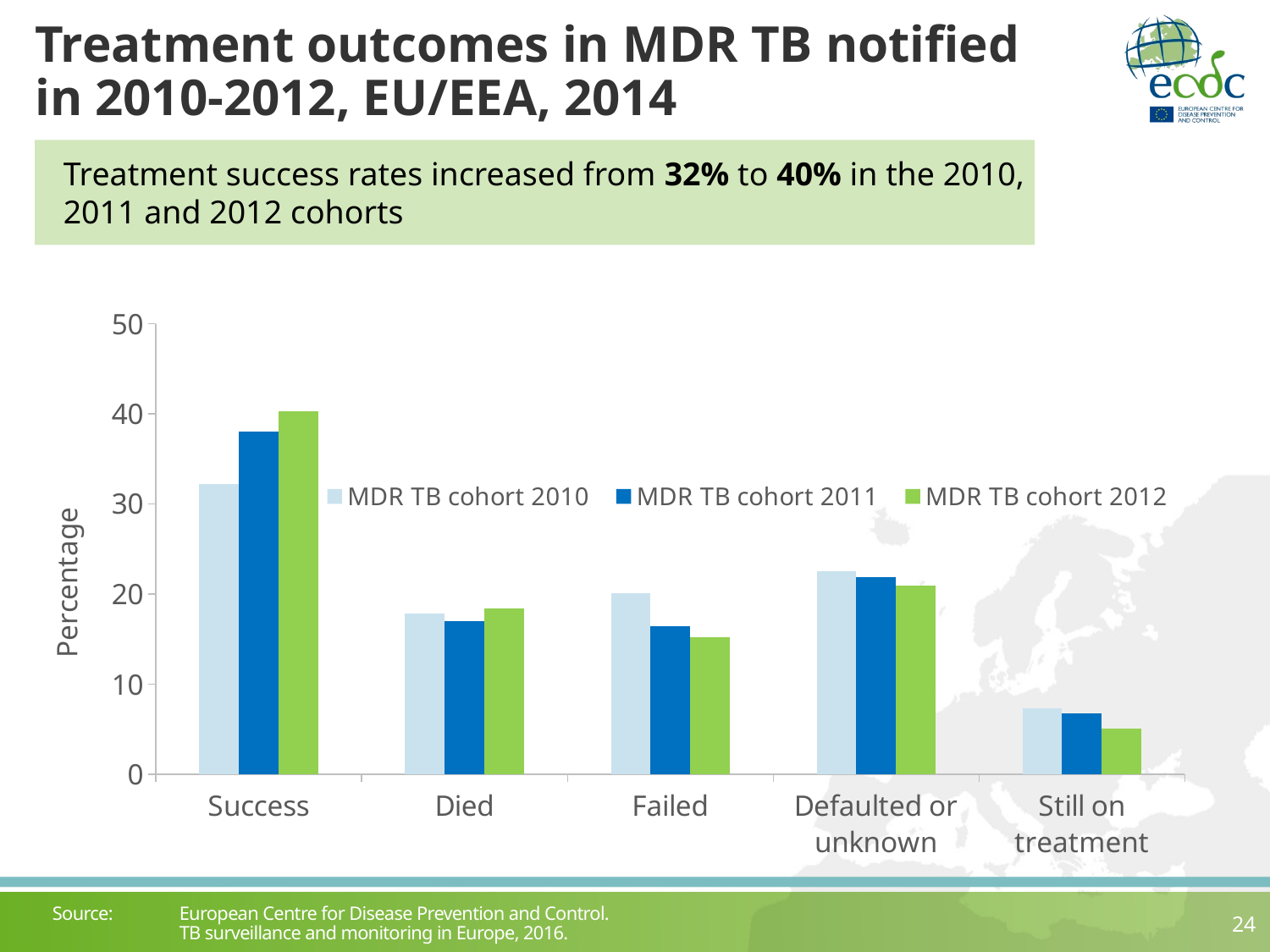
For the Success category, which is larger: the MDR TB cohort 2010 or the MDR TB cohort 2012? MDR TB cohort 2012 How many outcome categories are shown on the x axis of the chart? 5 Across the 2010, 2011 and 2012 cohorts, do the values for Failed rise or fall? fall Is the value for Defaulted or unknown in the MDR TB cohort 2010 greater or less than 20? greater What kind of chart is shown on the slide? Bar chart Which outcome category has the lowest value for the MDR TB cohort 2010? Still on treatment Which outcome category has the highest value for the MDR TB cohort 2012? Success Is the value for Died in the MDR TB cohort 2010 greater or less than 20? less Is the value for Success in the MDR TB cohort 2011 greater or less than 40? less What is the label on the vertical axis of the chart? Percentage How many series does the chart's legend list? 3